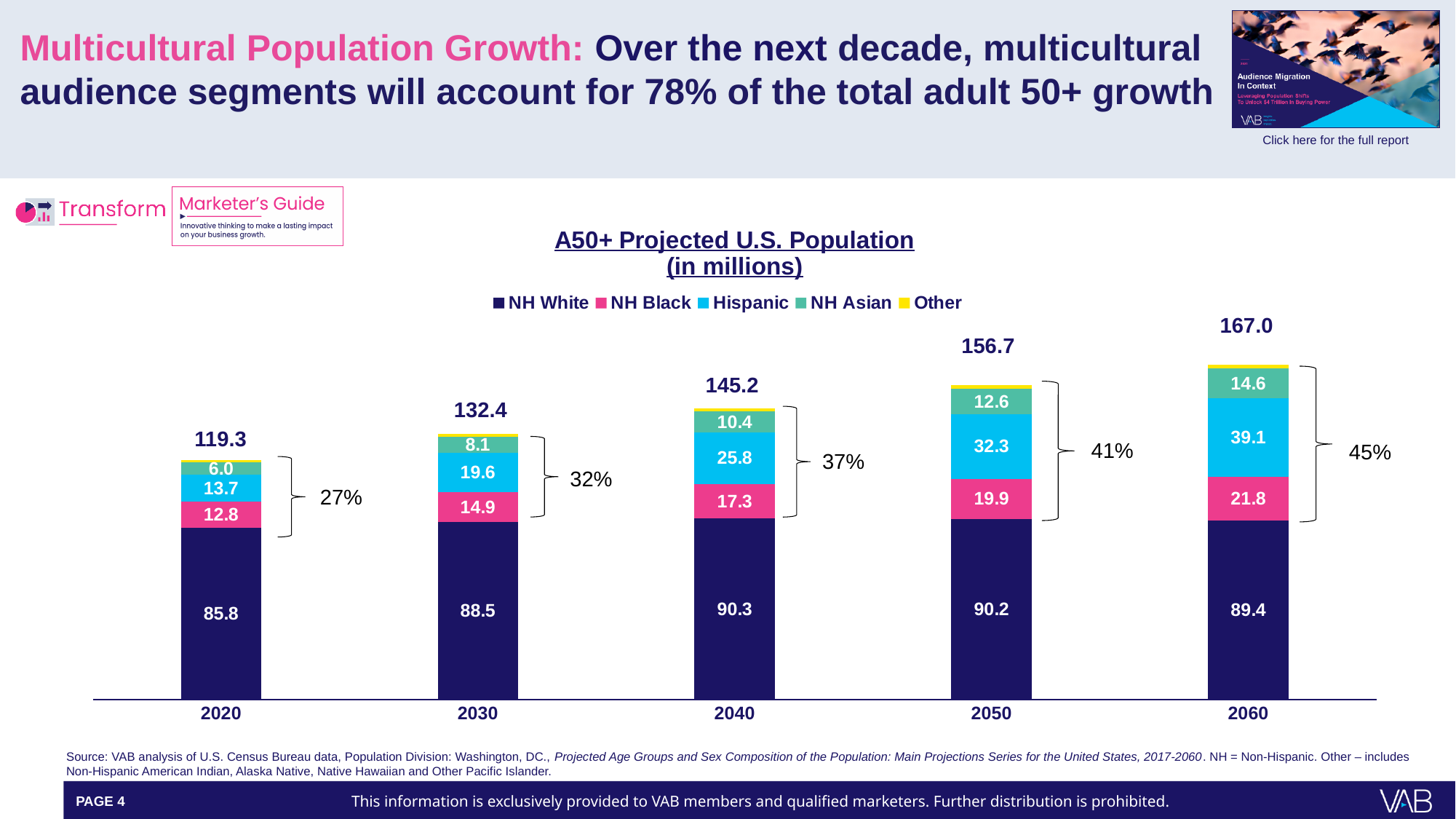
Which year has the highest total A50+ population? 2060 Do the total A50+ population values rise or fall from 2020 to 2060? Rise How many years are shown on the x axis? 5 What is the NH Asian value for 2060? 14.6 How many series does the legend list? 5 Is the NH White value larger in 2040 or in 2060? 2040 What is the Hispanic value for 2050? 32.3 What type of chart is shown on the slide? Stacked bar chart What is the difference between the NH Black values for 2060 and 2020? 9.0 What is the total A50+ population shown for 2040? 145.2 What is the NH White value for 2020? 85.8 Which year has the lowest Hispanic value? 2020